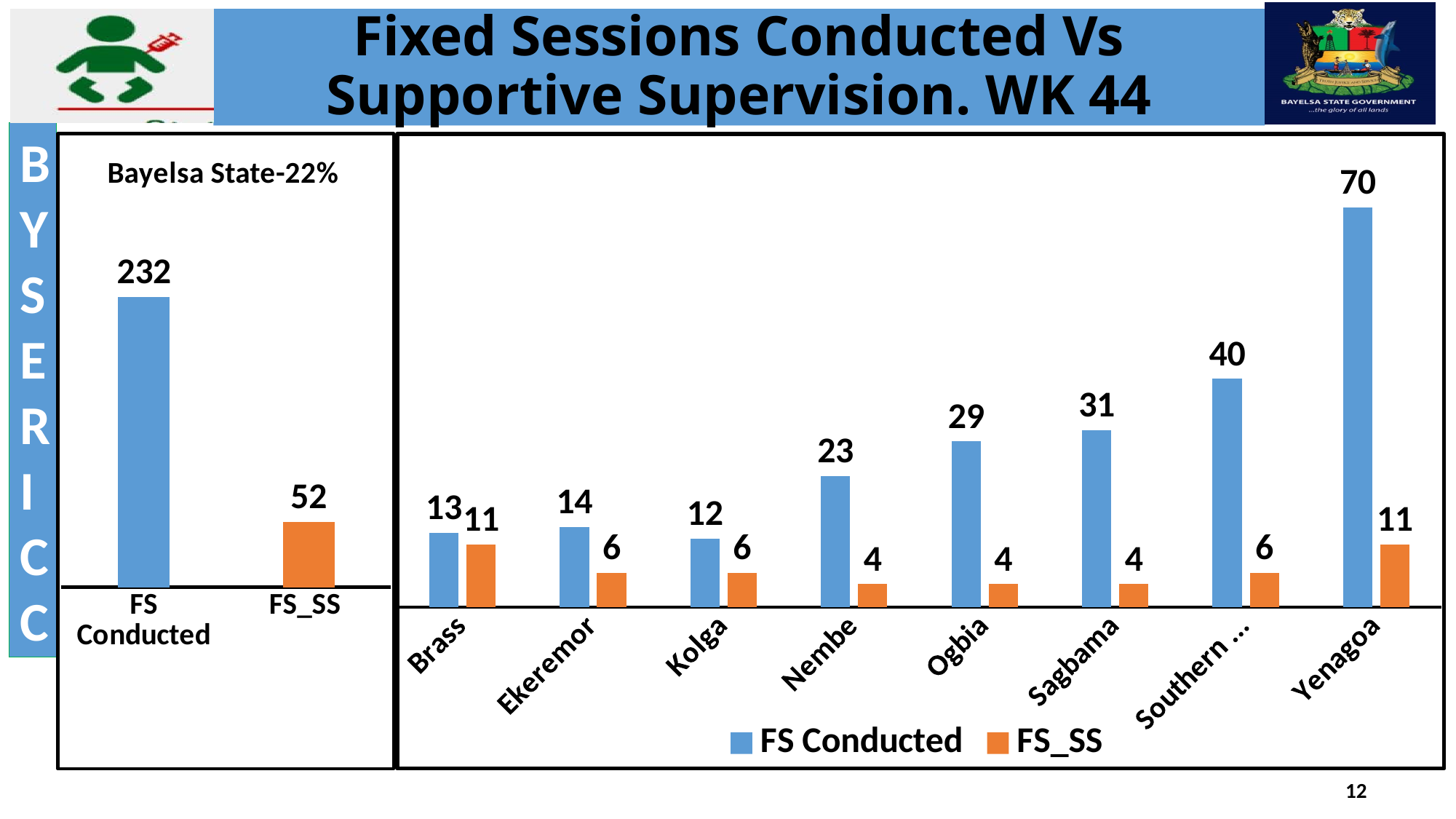
What type of chart is the right chart? Bar chart In the right chart, how many series does the legend list? 2 In the right chart, which LGA has the highest FS Conducted value? Yenagoa In the right chart, which LGA has the lowest FS Conducted value? Kolga In the right chart, which is larger: FS Conducted for Ogbia or FS Conducted for Sagbama? Sagbama In the left chart (Bayelsa State-22%), what is the value for FS Conducted? 232 In the right chart, what is the FS_SS value for Brass? 11 In the right chart, how many LGAs are shown on the x axis? 8 In the right chart, what is the difference between FS Conducted and FS_SS for Nembe? 19 In the left chart (Bayelsa State-22%), what is the value for FS_SS? 52 In the left chart (Bayelsa State-22%), what is the difference between FS Conducted and FS_SS? 180 In the right chart, what is the FS Conducted value for Yenagoa? 70